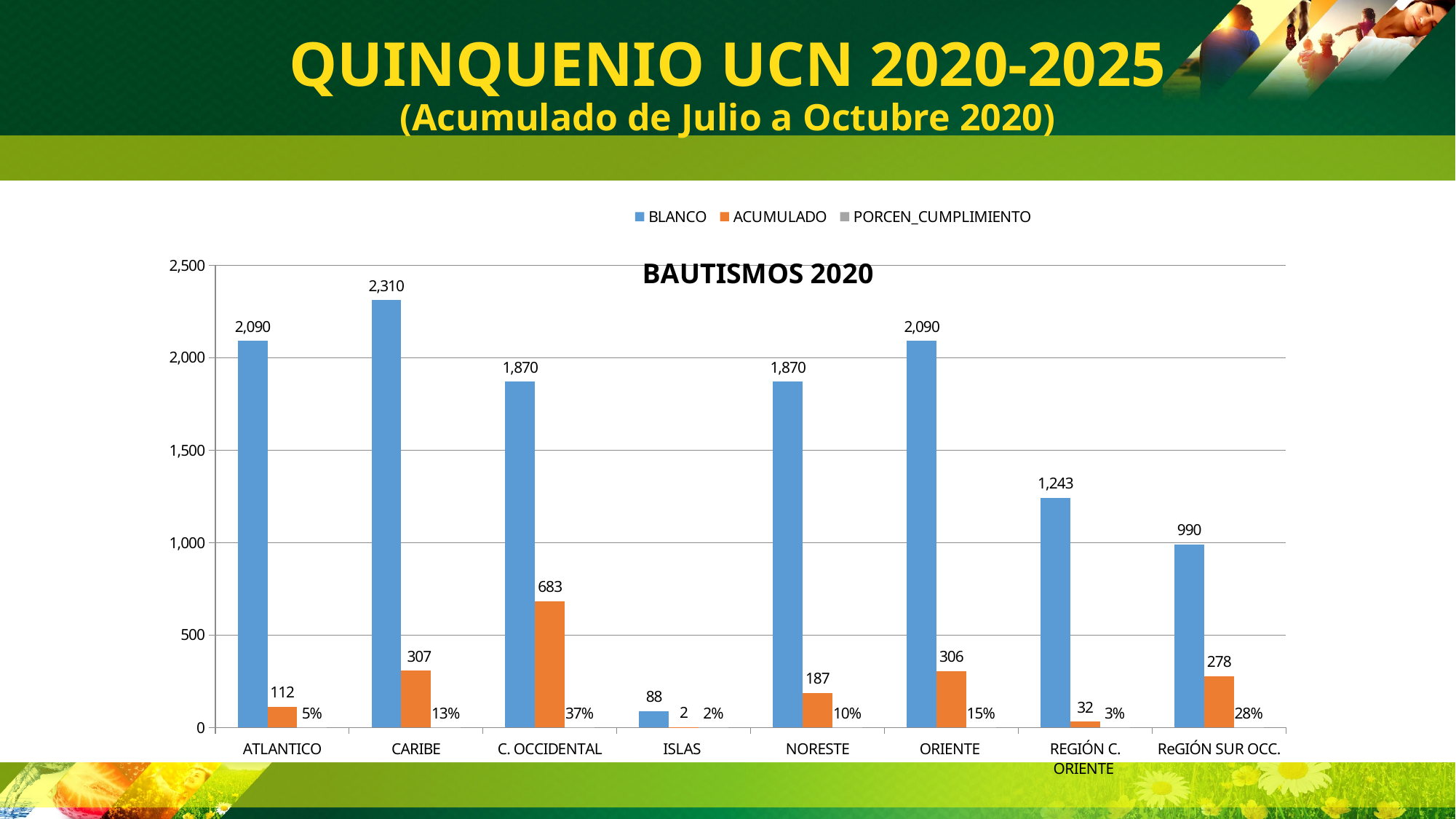
Which is larger, the ACUMULADO value for CARIBE or for ORIENTE? CARIBE How many categories are shown on the x axis? 8 What is the title of the chart? BAUTISMOS 2020 What is the PORCEN_CUMPLIMIENTO value for ReGIÓN SUR OCC.? 28% Which category has the lowest ACUMULADO value? ISLAS What is the ACUMULADO value for C. OCCIDENTAL? 683 What is the difference between the BLANCO and ACUMULADO values for NORESTE? 1,683 What is the ACUMULADO value for ISLAS? 2 Which category has the highest BLANCO value? CARIBE What kind of chart is shown on the slide? Bar chart How many series does the legend list? 3 What is the BLANCO value for CARIBE? 2,310